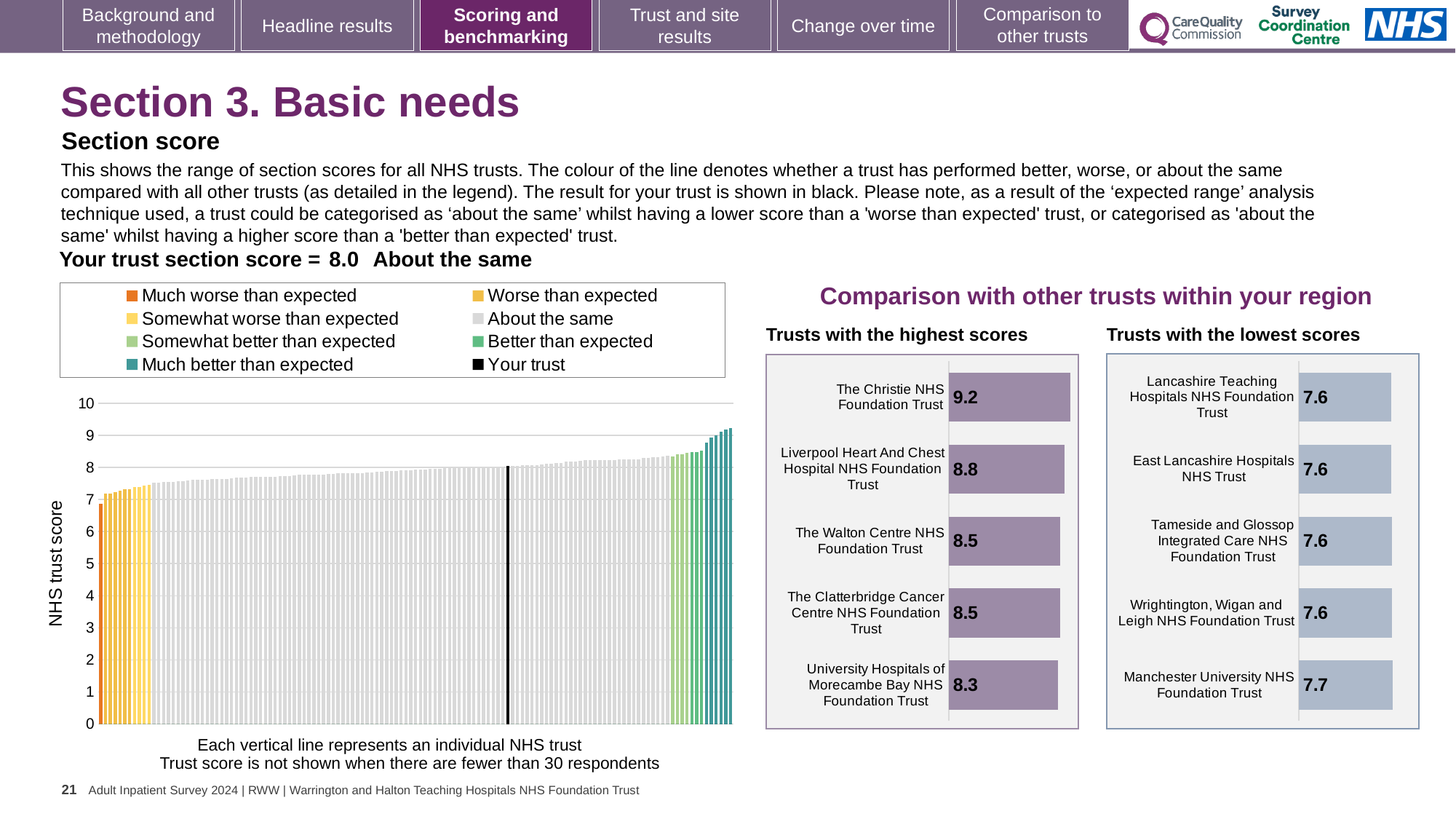
In the 'Trusts with the highest scores' chart, what is the difference between the scores of The Christie NHS Foundation Trust and University Hospitals of Morecambe Bay NHS Foundation Trust? 0.9 In the 'Trusts with the highest scores' chart, which has the larger score: Liverpool Heart And Chest Hospital NHS Foundation Trust or The Walton Centre NHS Foundation Trust? Liverpool Heart And Chest Hospital NHS Foundation Trust In the main NHS trust score chart on the left, do the bar values rise or fall from left to right? rise In the main NHS trust score chart on the left, what is the section score for your trust (the black bar)? 8.0 In the 'Trusts with the highest scores' chart, which trust has the highest score? The Christie NHS Foundation Trust How many entries does the legend of the main NHS trust score chart list? 8 In the main NHS trust score chart on the left, is the value of the rightmost bar greater or less than 9? greater How many trusts are shown in the 'Trusts with the lowest scores' chart? 5 In the 'Trusts with the highest scores' chart, what is the score for The Christie NHS Foundation Trust? 9.2 In the 'Trusts with the lowest scores' chart, which trust has the highest score? Manchester University NHS Foundation Trust In the 'Trusts with the lowest scores' chart, what is the score for Manchester University NHS Foundation Trust? 7.7 In the 'Trusts with the highest scores' chart, what is the score for University Hospitals of Morecambe Bay NHS Foundation Trust? 8.3